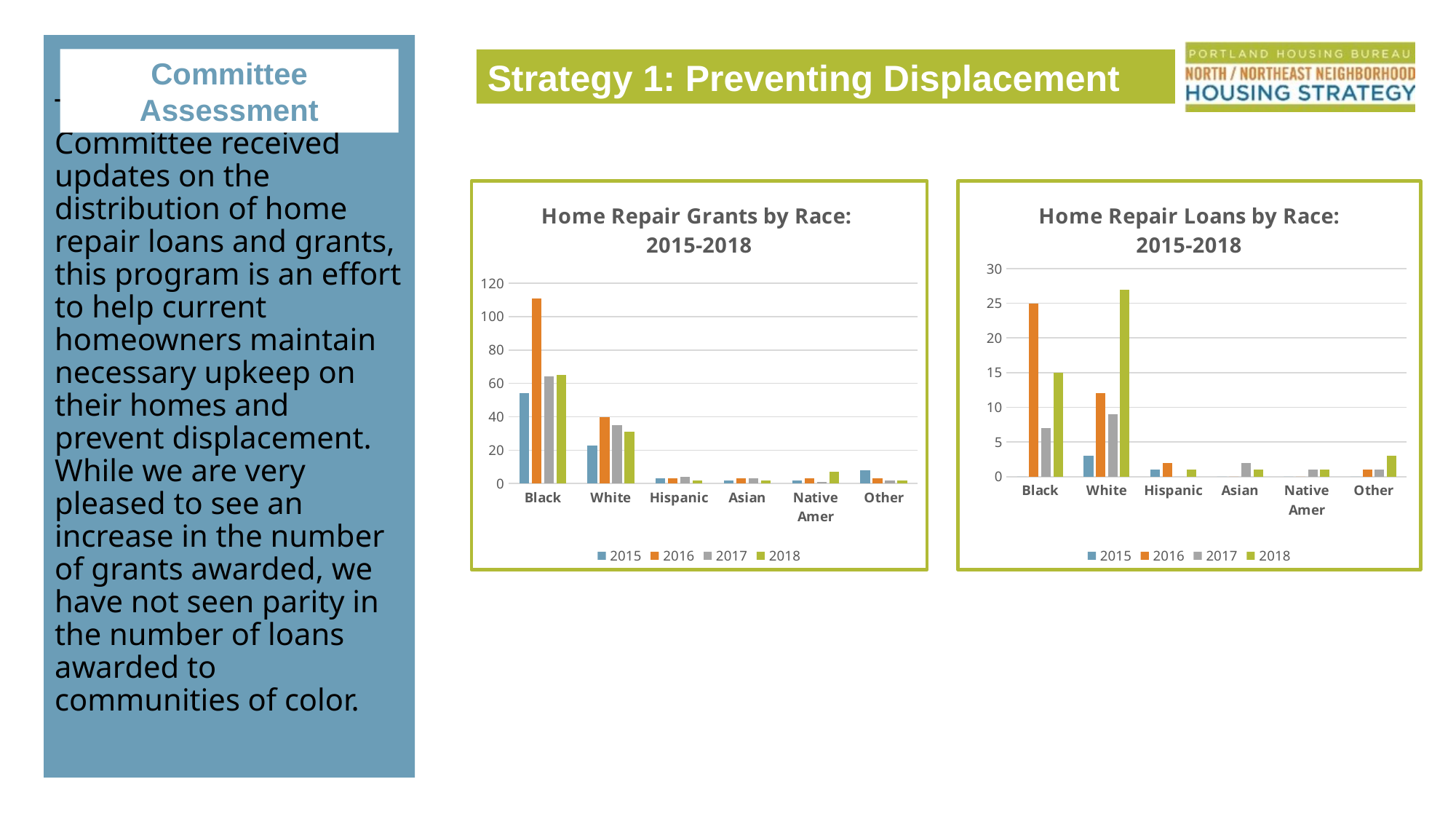
How many series does the legend of the 'Home Repair Loans by Race: 2015-2018' chart list? 4 In the 'Home Repair Grants by Race: 2015-2018' chart, which category has the tallest bar overall? Black In the 'Home Repair Grants by Race: 2015-2018' chart, is the 2016 value for White greater or less than 60? less How many race categories are shown on the x axis of the 'Home Repair Grants by Race: 2015-2018' chart? 6 In the 'Home Repair Loans by Race: 2015-2018' chart, which category has the tallest bar overall? White In the 'Home Repair Loans by Race: 2015-2018' chart, is the 2018 value for White greater or less than 25? greater In the 'Home Repair Grants by Race: 2015-2018' chart, is the 2016 value for Black greater or less than 100? greater What kind of chart is the 'Home Repair Grants by Race: 2015-2018' chart? bar chart In the 'Home Repair Loans by Race: 2015-2018' chart, what colour represents the 2016 series? orange In the 'Home Repair Loans by Race: 2015-2018' chart, what is the 2016 value for Black? 25 In the 'Home Repair Loans by Race: 2015-2018' chart, which is larger for Black, the 2016 value or the 2017 value? 2016 In the 'Home Repair Grants by Race: 2015-2018' chart, which is larger, the 2015 value for Black or the 2015 value for White? Black